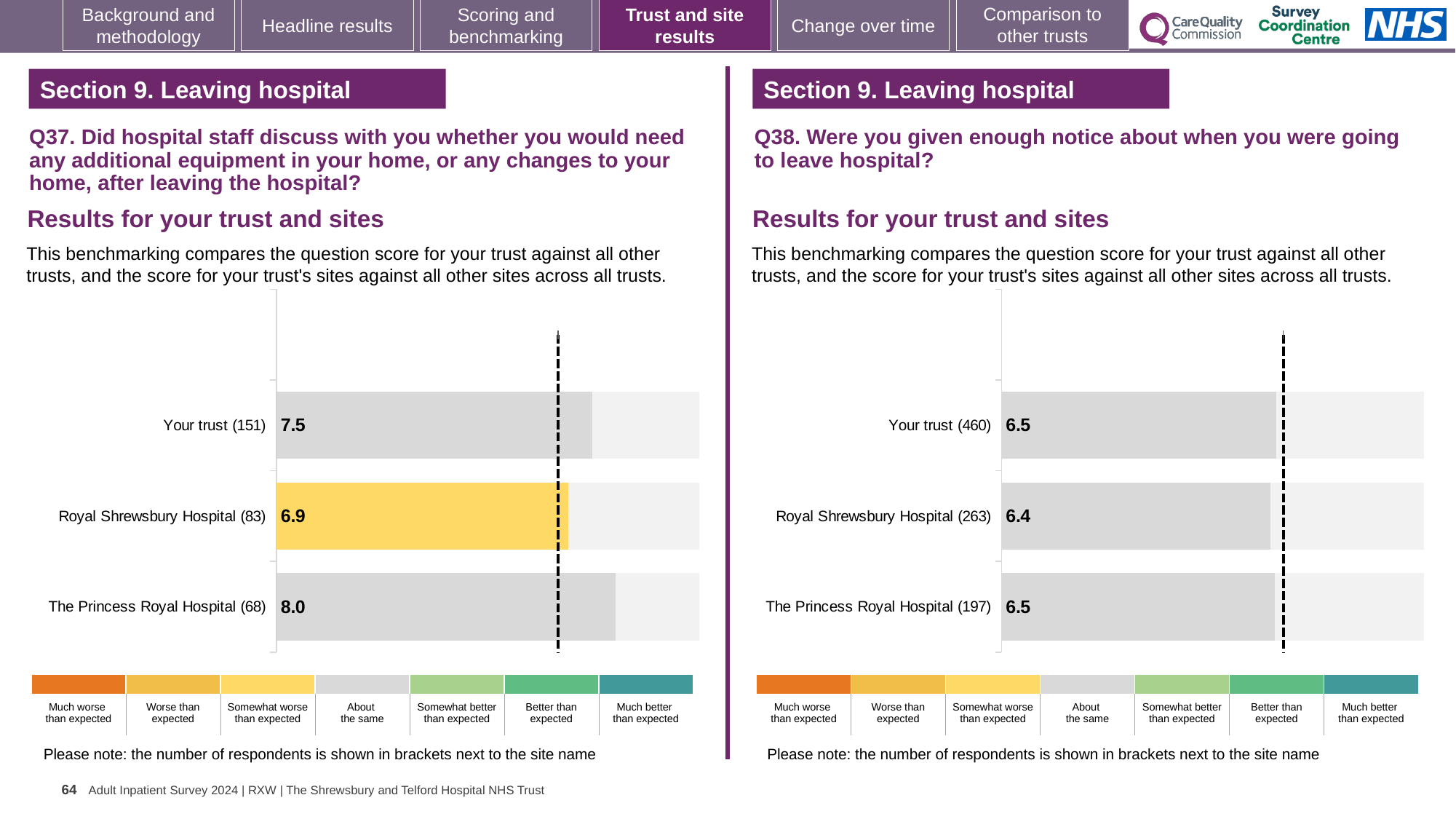
In the Q38 chart on the right, what is the score for Royal Shrewsbury Hospital? 6.4 In the Q37 chart on the left, which site or trust has the lowest score? Royal Shrewsbury Hospital How many bars are plotted in the Q38 chart on the right? 3 What kind of chart is used in the Q37 chart on the left? Bar chart In the Q37 chart on the left, what is the score for Royal Shrewsbury Hospital? 6.9 In the Q37 chart on the left, which site or trust has the highest score? The Princess Royal Hospital In the Q37 chart on the left, what is the score for Your trust? 7.5 In the Q37 chart on the left, what is the difference between the scores for The Princess Royal Hospital and Royal Shrewsbury Hospital? 1.1 In the Q37 chart on the left, which bar is coloured yellow rather than grey? Royal Shrewsbury Hospital In the Q37 chart on the left, what is the score for The Princess Royal Hospital? 8.0 In the Q38 chart on the right, what is the difference between the scores for Your trust and Royal Shrewsbury Hospital? 0.1 In the Q38 chart on the right, what is the score for Your trust? 6.5